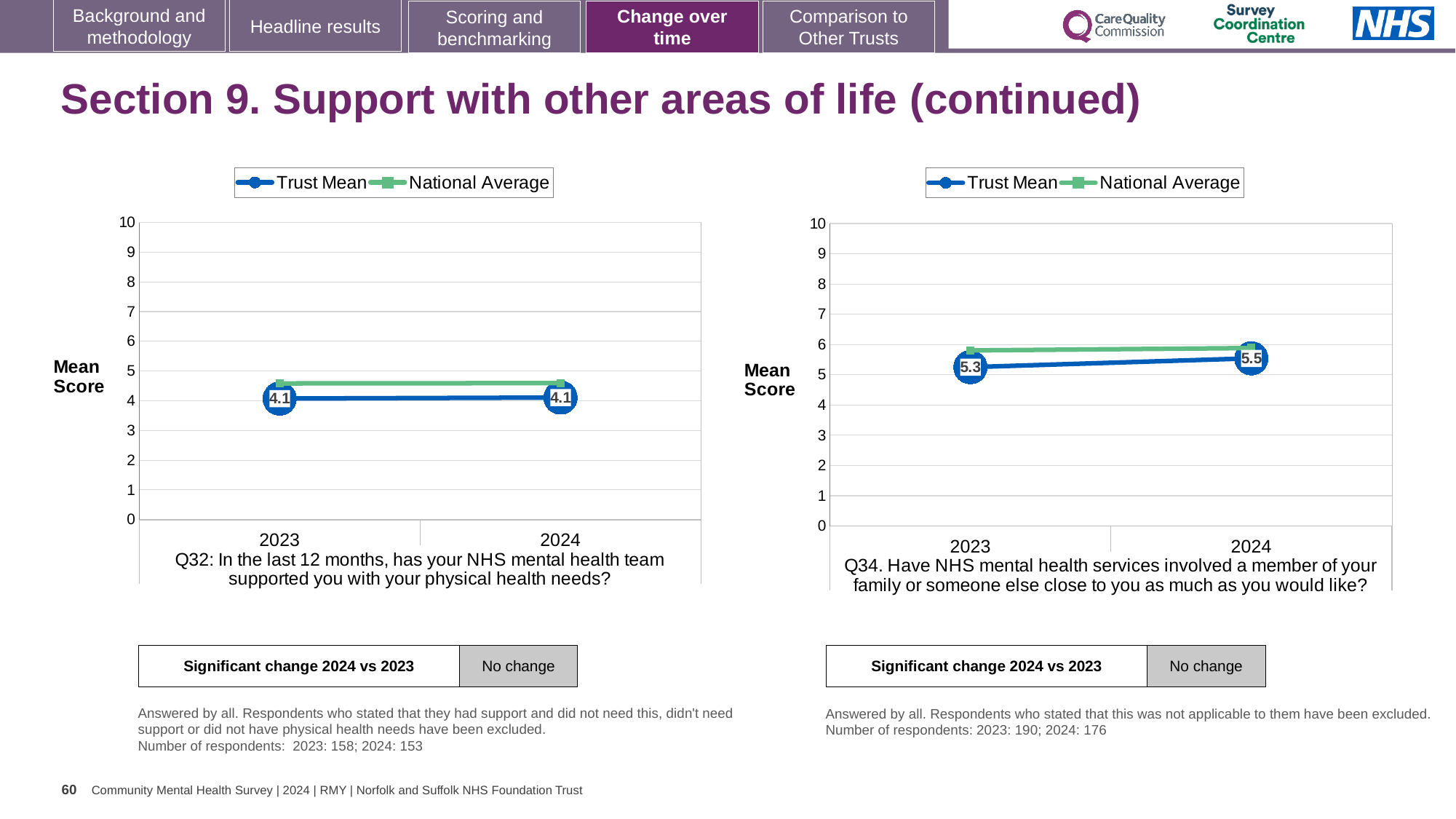
How many years are plotted on the x axis of the Q34 chart on the right? 2 In the Q32 chart on the left, what is the Trust Mean score for 2023? 4.1 In the Q34 chart on the right, what is the difference between the Trust Mean scores for 2024 and 2023? 0.2 What kind of chart is the Q32 chart on the left? line chart How many series does the legend of the Q32 chart on the left list? 2 In the Q34 chart on the right, is the National Average value for 2024 greater or less than 5? greater In the Q34 chart on the right, does the Trust Mean rise or fall from 2023 to 2024? rise In the Q34 chart on the right, what is the Trust Mean score for 2024? 5.5 In the Q32 chart on the left, what is the Trust Mean score for 2024? 4.1 In the Q32 chart on the left, is the National Average value for 2023 greater or less than 4? greater In the Q34 chart on the right, which year has the higher Trust Mean score, 2023 or 2024? 2024 In the Q34 chart on the right, what is the Trust Mean score for 2023? 5.3